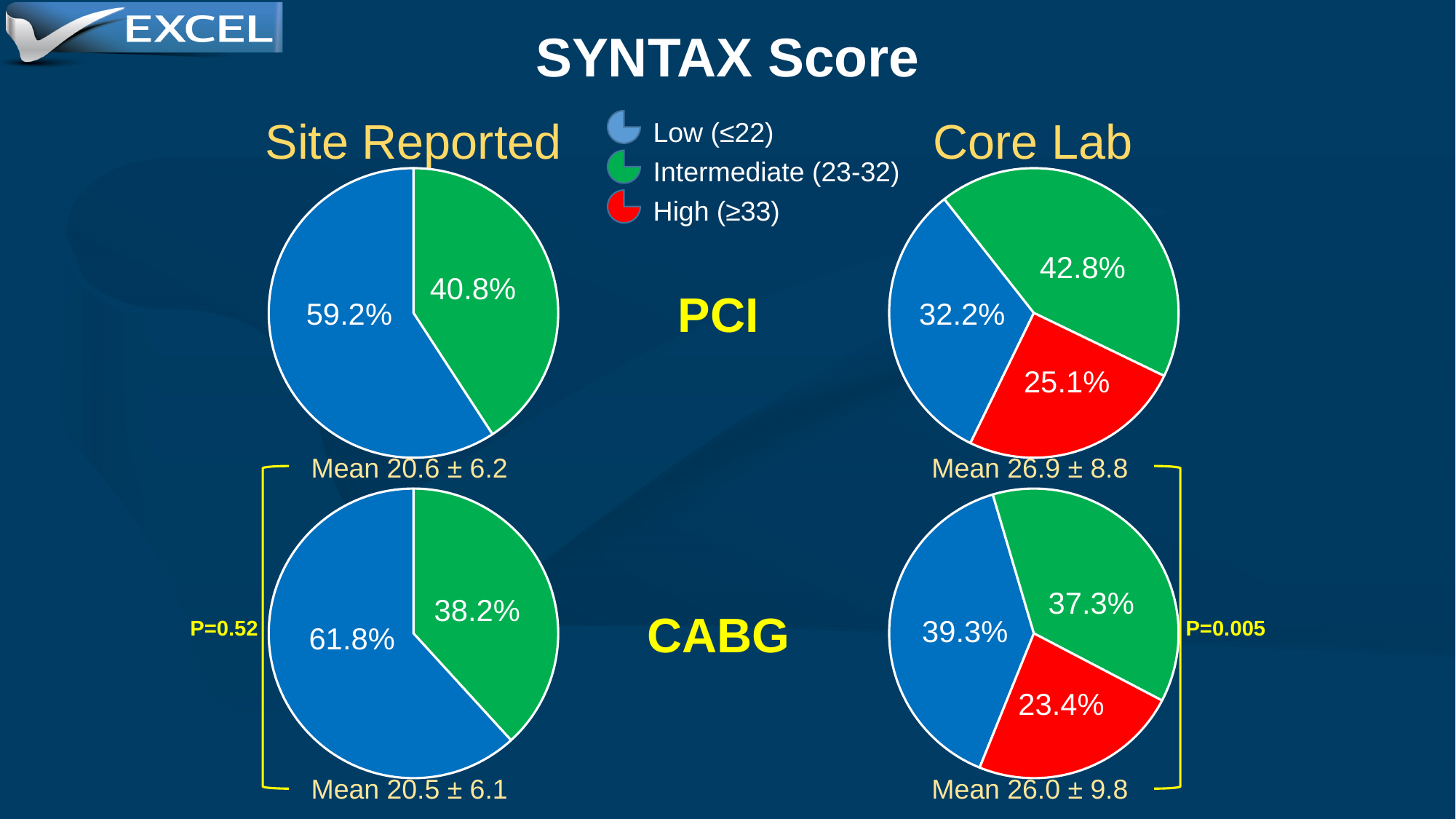
In the Core Lab PCI pie chart, what share is High (≥33)? 25.1% How many categories does the legend list? 3 What type of chart is used on this slide? Pie chart In the Core Lab CABG pie chart, what share is Intermediate (23-32)? 37.3% In the Core Lab CABG pie chart, which category has the smallest share? High (≥33) In the Core Lab CABG pie chart, which is larger: the Low share or the Intermediate share? Low (≤22) In the Site Reported CABG pie chart, what share is Intermediate (23-32)? 38.2% In the Site Reported PCI pie chart, what is the difference between the Low and Intermediate shares? 18.4% How many slices does the Core Lab PCI pie chart have? 3 In the Site Reported PCI pie chart, what share is Low (≤22)? 59.2% In the Core Lab PCI pie chart, which category has the largest share? Intermediate (23-32) What is the mean SYNTAX score shown under the Core Lab PCI pie chart? Mean 26.9 ± 8.8